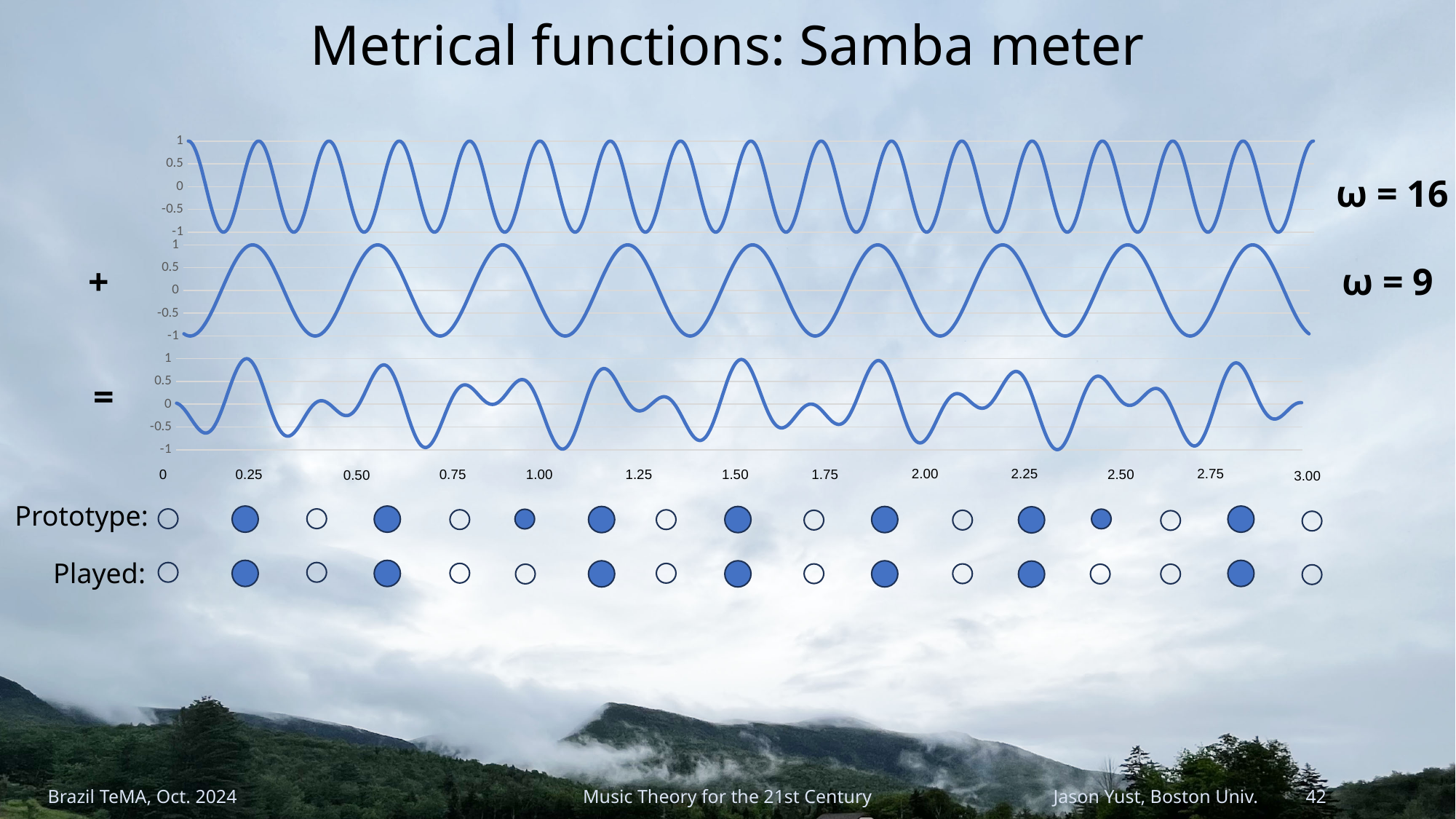
What is the last tick label on the x axis? 3.00 What ω value is labelled next to the top wave plot? ω = 16 How many separate wave plots are stacked on the slide? 3 In the bottom (sum) plot, is the value at x = 1.50 greater or less than 0.5? greater What kind of chart is used for the three plots on the slide? line chart What ω value is labelled next to the middle wave plot? ω = 9 In the top plot (ω = 16), what is the value of the wave at x = 0? 1 In the bottom (sum) plot, is the value at x = 0.25 greater or less than 0.5? greater How many tick labels are shown on the shared x axis (from 0 to 3.00)? 13